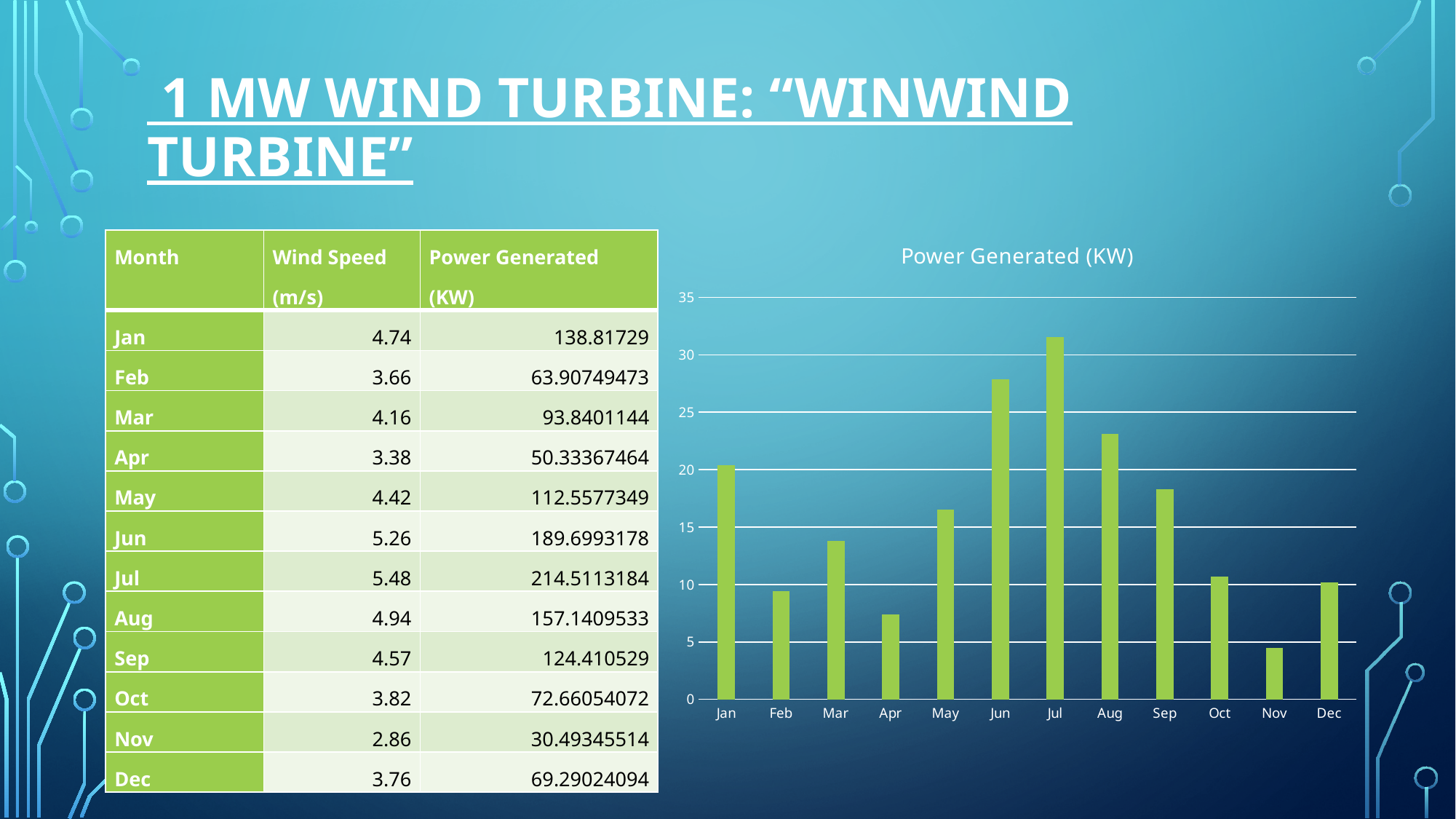
Is the value for Apr greater or less than 10? less Which month has the lowest bar in the chart? Nov Do the bars rise or fall from Apr to Jul? rise Is the value for Jun greater or less than 25? greater What kind of chart is shown on the slide? bar chart Which month has the highest bar in the chart? Jul What is the title of the chart? Power Generated (KW) Which bar is taller, Feb or Mar? Mar Is the value for Sep greater or less than 15? greater Which bar is taller, Jun or Aug? Jun How many months are plotted on the chart's x axis? 12